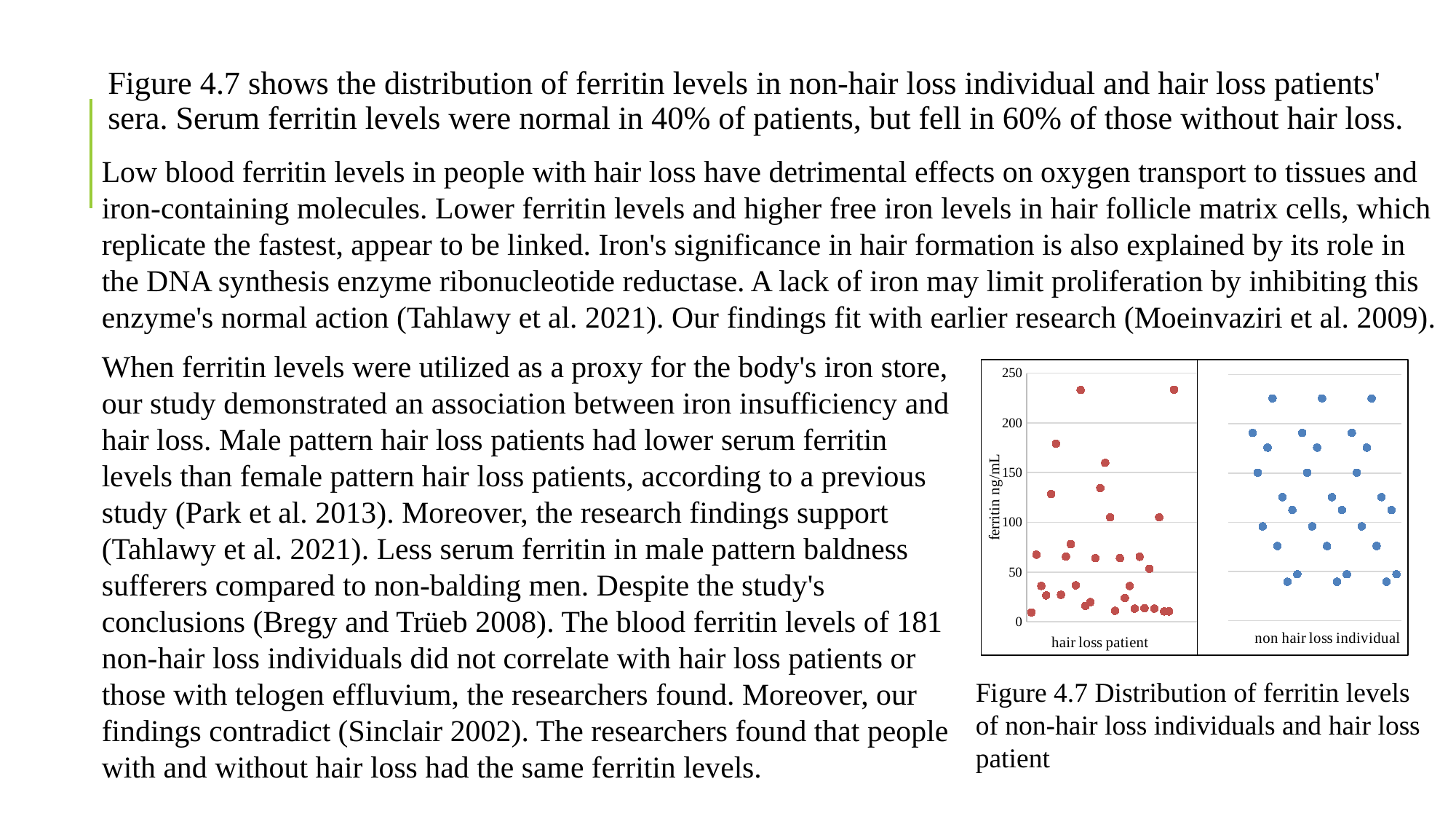
In the chart in Figure 4.7, is the highest ferritin value for a hair loss patient greater or less than 200? greater What kind of chart is shown in Figure 4.7? scatter chart What is the maximum value shown on the vertical axis of the chart in Figure 4.7? 250 How many groups of individuals are plotted in the chart in Figure 4.7? 2 In the chart in Figure 4.7, which group has the lower minimum ferritin value, hair loss patient or non hair loss individual? hair loss patient What is the label on the vertical axis of the chart in Figure 4.7? ferritin ng/mL In the chart in Figure 4.7, is the highest ferritin value for a non hair loss individual greater or less than 250? less In the chart in Figure 4.7, is the lowest ferritin value for a hair loss patient greater or less than 50? less In the chart in Figure 4.7, which group has more points below 50 ng/mL, hair loss patient or non hair loss individual? hair loss patient What are the two groups labelled along the bottom of the chart in Figure 4.7? hair loss patient and non hair loss individual